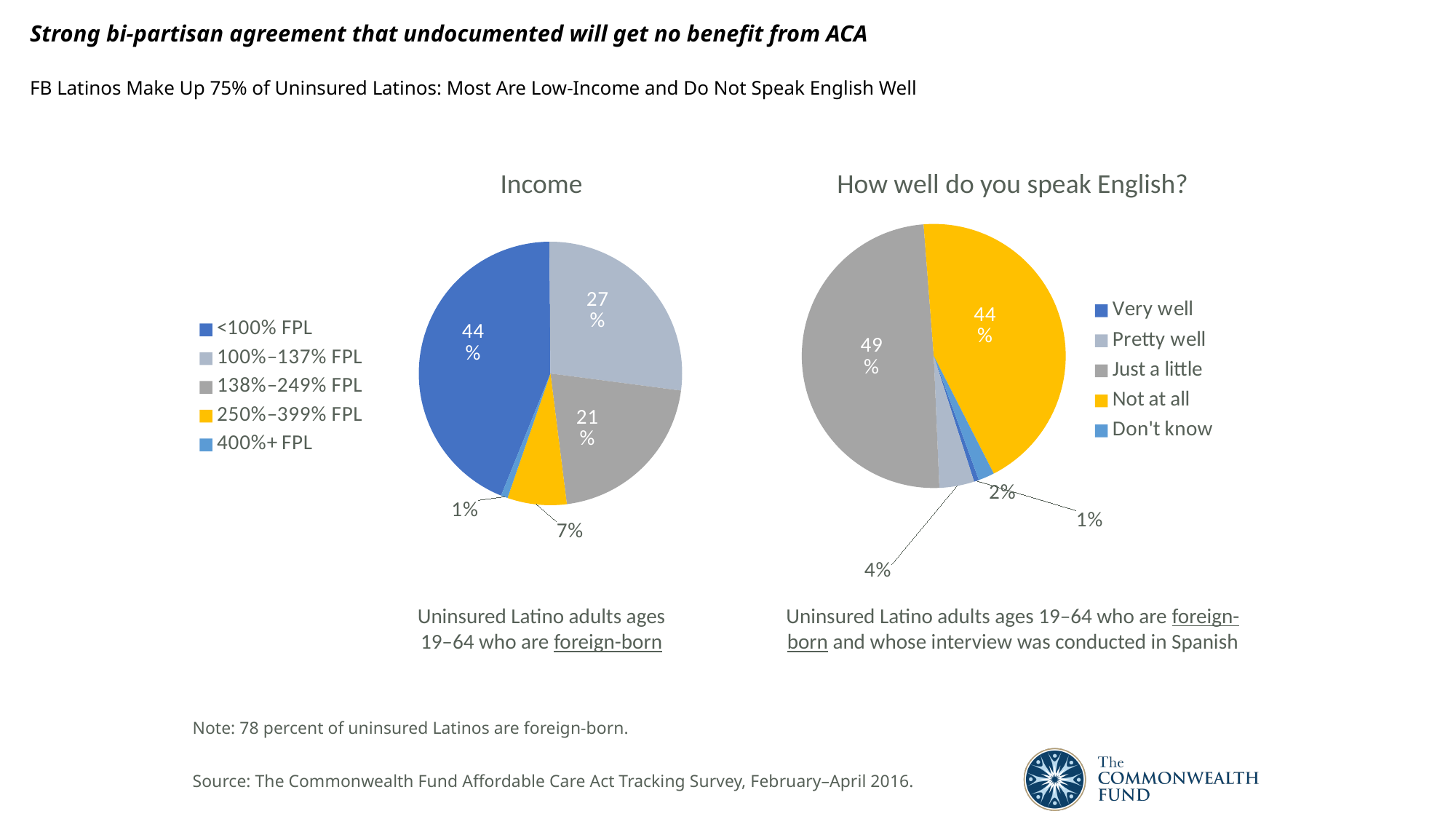
In the Income chart, what is the difference between the 138%–249% FPL share and the 250%–399% FPL share? 14% What kind of charts are shown on the slide? Pie charts In the 'How well do you speak English?' chart, what share answered 'Pretty well'? 4% In the Income chart, which income category has the smallest share? 400%+ FPL In the 'How well do you speak English?' chart, what share answered 'Just a little'? 49% In the Income chart, what share of uninsured foreign-born Latino adults have incomes below 100% FPL? 44% In the 'How well do you speak English?' chart, which colour represents 'Not at all'? Yellow In the Income chart, what is the value for 100%–137% FPL? 27% In the Income chart, how many income categories does the legend list? 5 In the 'How well do you speak English?' chart, what share answered 'Not at all'? 44% In the 'How well do you speak English?' chart, which response has the largest share? Just a little In the Income chart, what is the value for 250%–399% FPL? 7%